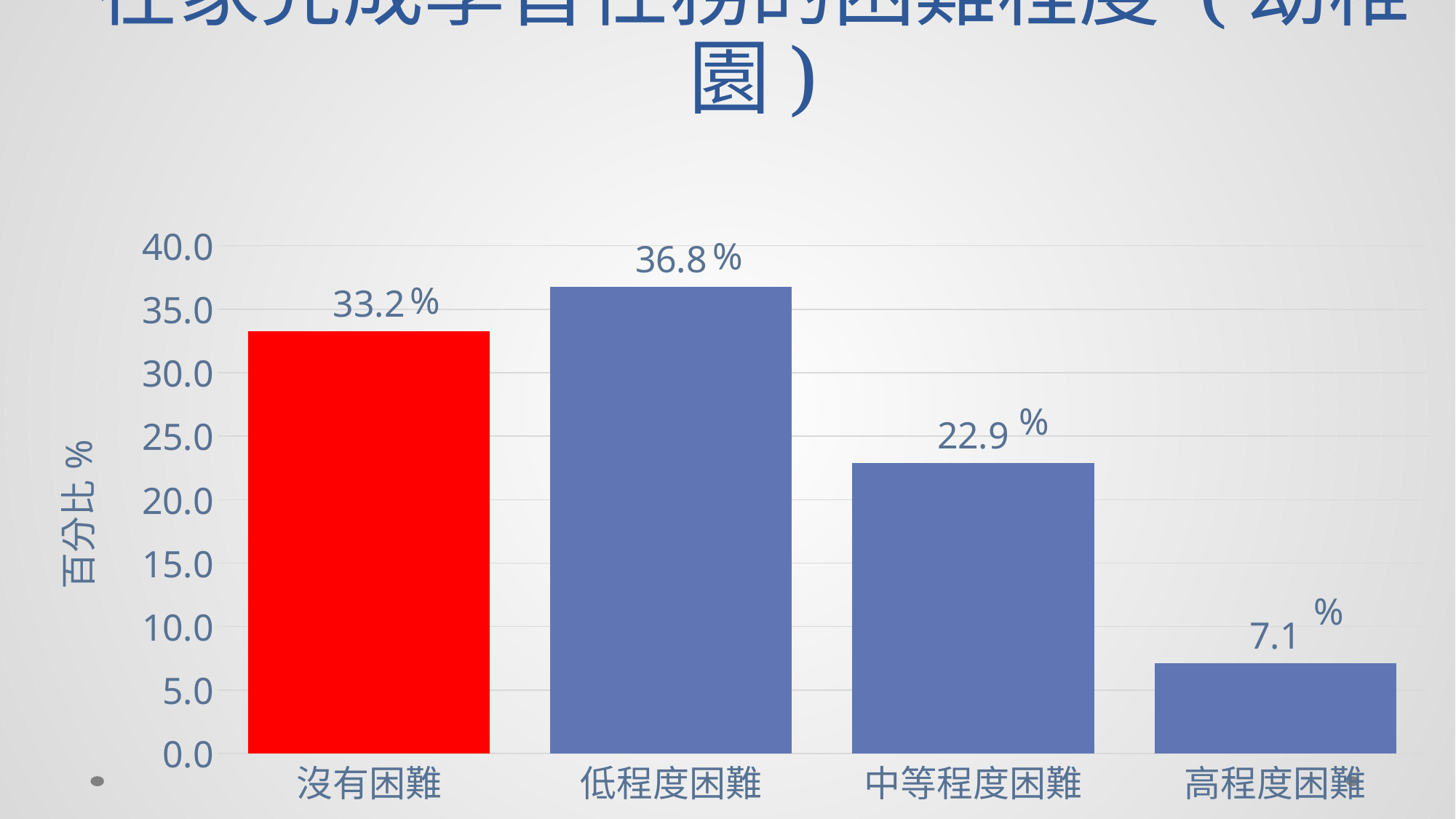
Which category has the lowest value? 高程度困難 What is the difference between the values for 中等程度困難 and 高程度困難? 15.8 % What is the value for 高程度困難? 7.1 % Which is larger, the value for 沒有困難 or the value for 中等程度困難? 沒有困難 What is the value for 沒有困難? 33.2 % Which category has the highest value? 低程度困難 What is the value for 低程度困難? 36.8 % What is the difference between the values for 低程度困難 and 沒有困難? 3.6 % How many categories are shown on the x axis? 4 What kind of chart is shown on the slide? bar chart Which bar is coloured red? 沒有困難 What is the value for 中等程度困難? 22.9 %